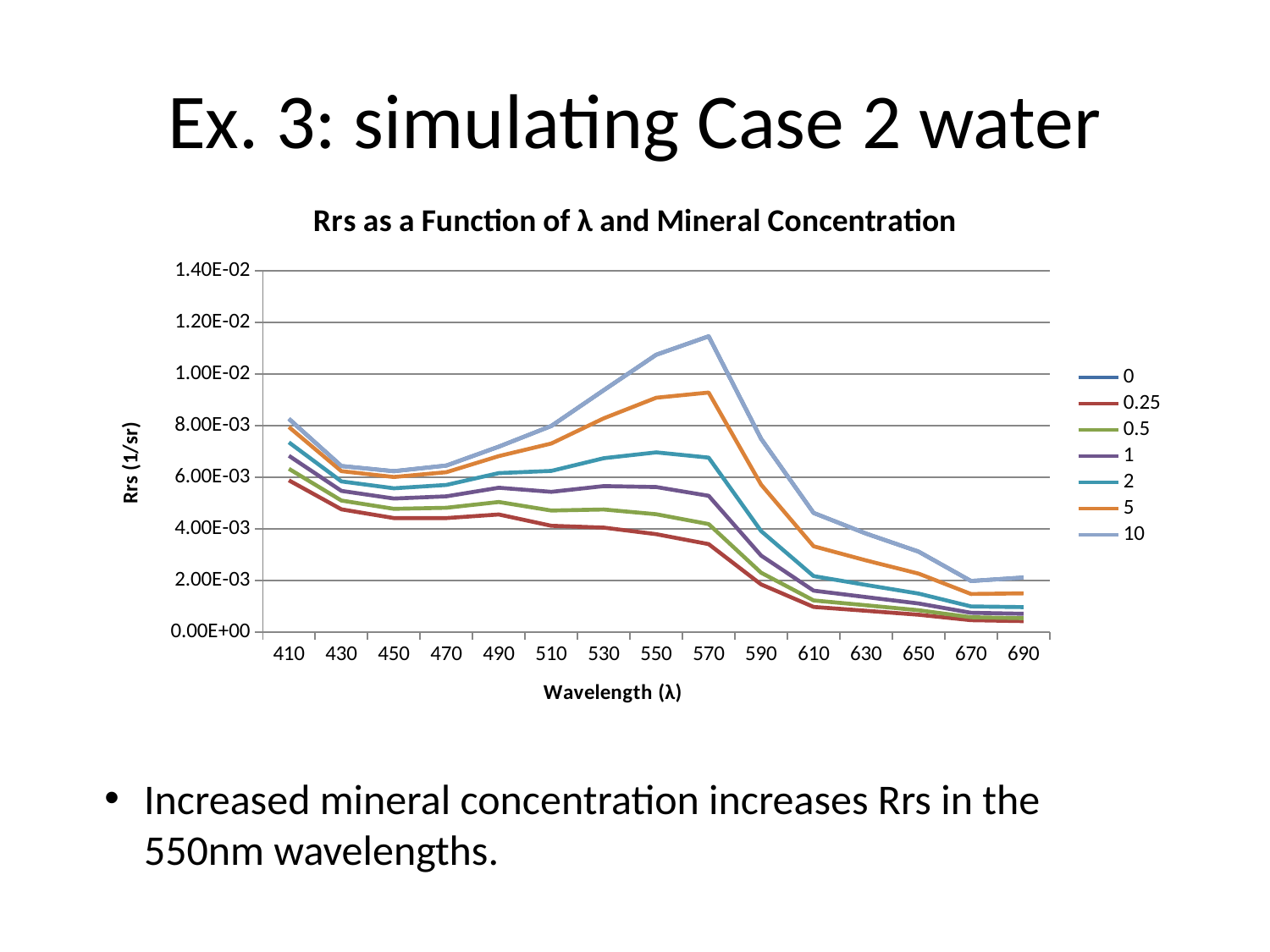
Is the value for series 0.25 at 690 greater or less than 2.00E-03? less How many wavelength points are plotted along the x axis? 15 What is the label of the y axis? Rrs (1/sr) Which series has the highest Rrs value at 570? 10 At which wavelength does the series 10 reach its highest value? 570 At 550, which series has the larger value, 10 or 2? 10 What kind of chart is shown on the slide? line chart How many series does the legend list? 7 Is the value for series 5 at 570 greater or less than 8.00E-03? greater Is the value for series 10 at 570 greater or less than 1.00E-02? greater Do the values for series 10 rise or fall from 570 to 670? fall What is the title of the chart? Rrs as a Function of λ and Mineral Concentration